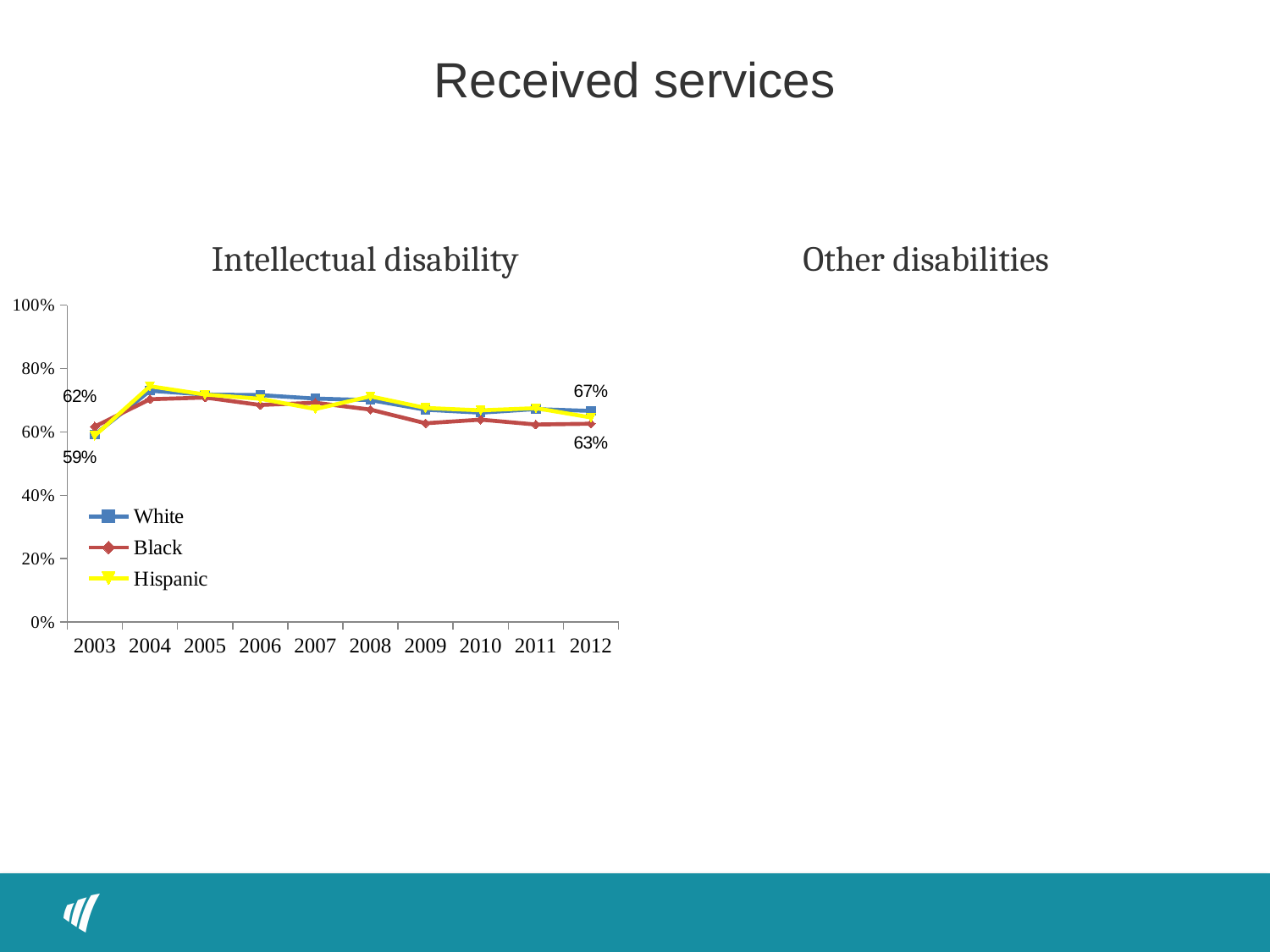
In the Intellectual disability chart, what is the highest labeled value shown for 2012? 67% What kind of chart is the Intellectual disability chart? line chart How many years are shown on the x axis of the Intellectual disability chart? 10 In the Intellectual disability chart, which series has the highest value in 2003? Black In the Intellectual disability chart, is the value for Hispanic in 2004 greater or less than 80%? less In the Intellectual disability chart, does the Black series rise or fall from 2004 to 2012? fall In the Intellectual disability chart, which series has the lowest value in 2012? Black In the Intellectual disability chart, which is larger in 2012: the value for White or the value for Black? White In the Intellectual disability chart, what is the labeled value for Black in 2003? 62% What is the title of the slide containing the Intellectual disability chart? Received services In the Intellectual disability chart, what is the labeled value for Black in 2012? 63% How many series does the legend of the Intellectual disability chart list? 3